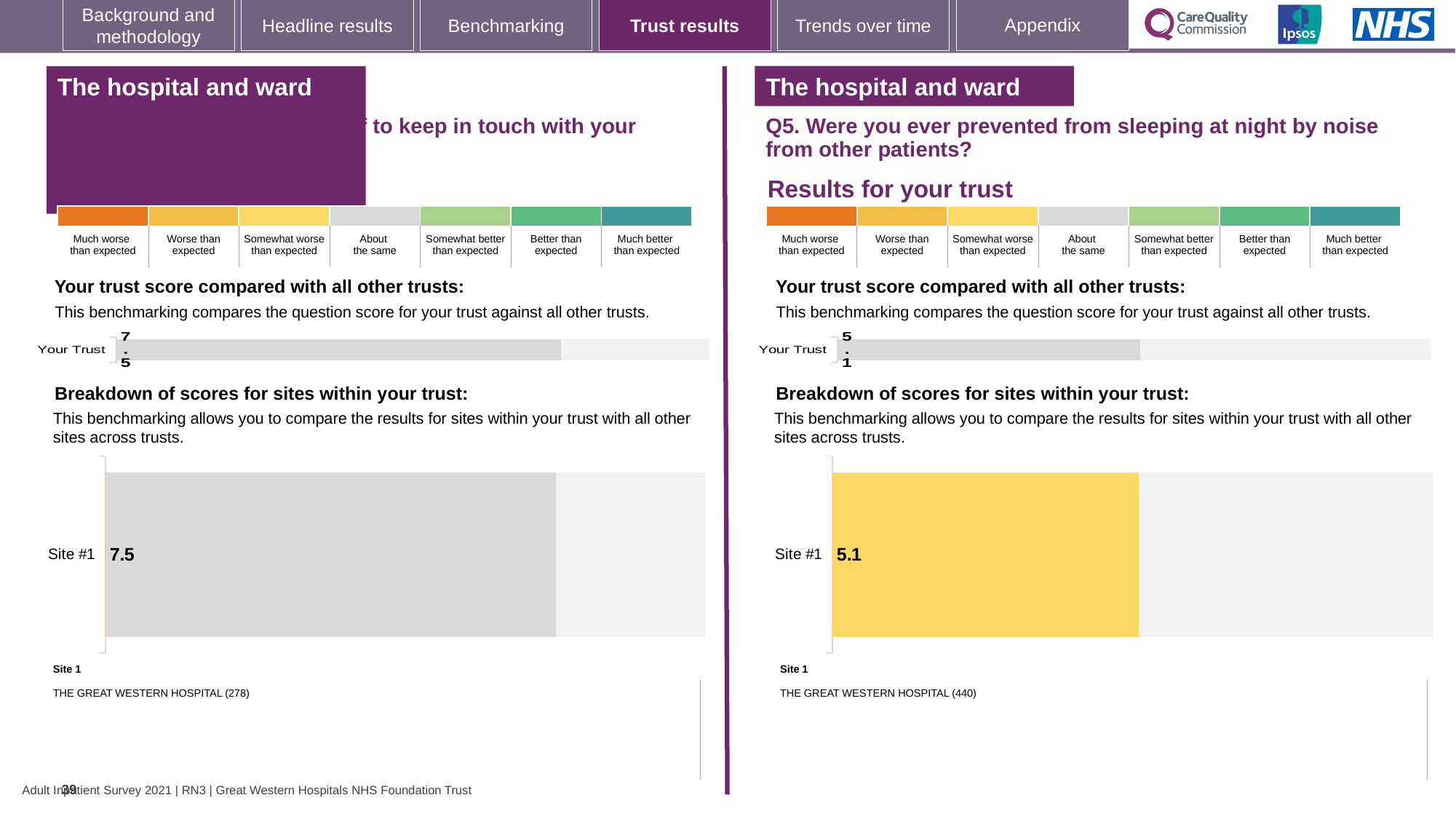
What is the difference between the Site #1 score in the left chart and the Site #1 score in the Q5 chart on the right? 2.4 In the Q5 chart on the right, what colour is the Site #1 bar? Yellow What kind of chart is used to show the Site #1 score in the Q5 chart on the right? Bar chart In the chart on the left side of the slide, what is the score shown for Site #1? 7.5 In the Q5 chart on the right, what number is shown in parentheses after THE GREAT WESTERN HOSPITAL for Site 1? 440 In the Q5 chart on the right, what is the score shown for Site #1? 5.1 In the chart on the left side of the slide, what number is shown in parentheses after THE GREAT WESTERN HOSPITAL for Site 1? 278 Which Site #1 score is larger: the one in the left chart or the one in the Q5 chart on the right? The left chart (7.5) How many sites are shown in the site breakdown chart for Q5 on the right? 1 According to the colour key, which benchmark category does the yellow Site #1 bar in the Q5 chart on the right correspond to? Somewhat worse than expected In the chart on the left side of the slide, what is the score shown for Your Trust? 7.5 In the Q5 chart on the right, what is the score shown for Your Trust? 5.1